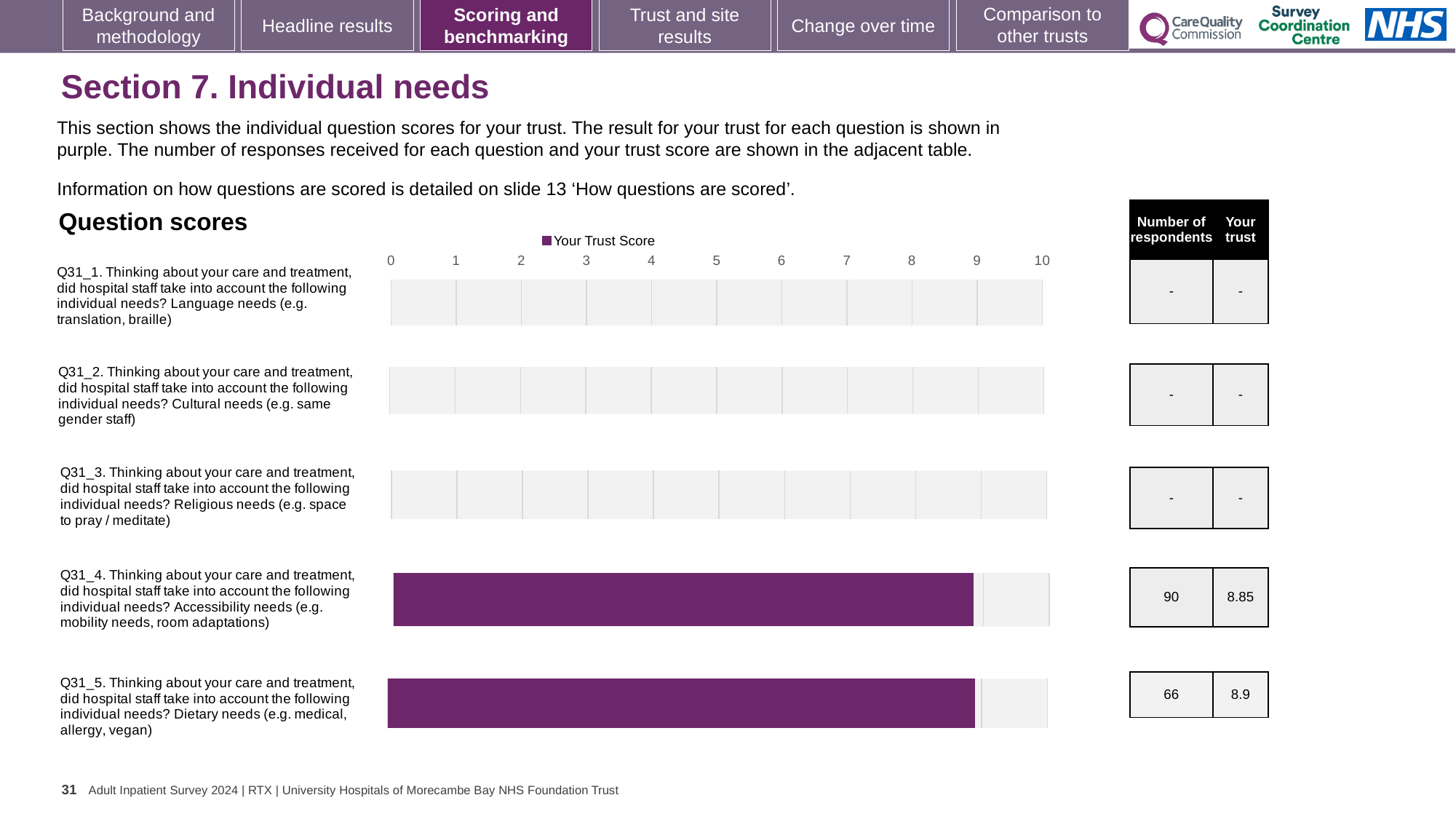
How many respondents answered Q31_5 (Dietary needs)? 66 What kind of chart is used to show the question scores? Bar chart Is the value for Q31_4 (Accessibility needs) greater or less than 8? greater What is the trust score for Q31_5 (Dietary needs)? 8.9 What is the difference between the trust scores for Q31_5 (Dietary needs) and Q31_4 (Accessibility needs)? 0.05 How many series does the chart legend list? 1 What is the name of the series shown in the chart legend? Your Trust Score How many respondents answered Q31_4 (Accessibility needs)? 90 How many questions are listed in the Question scores chart? 5 Is the value for Q31_5 (Dietary needs) greater or less than 7? greater What is the trust score for Q31_4 (Accessibility needs)? 8.85 What is shown as the trust score for Q31_1 (Language needs)? -